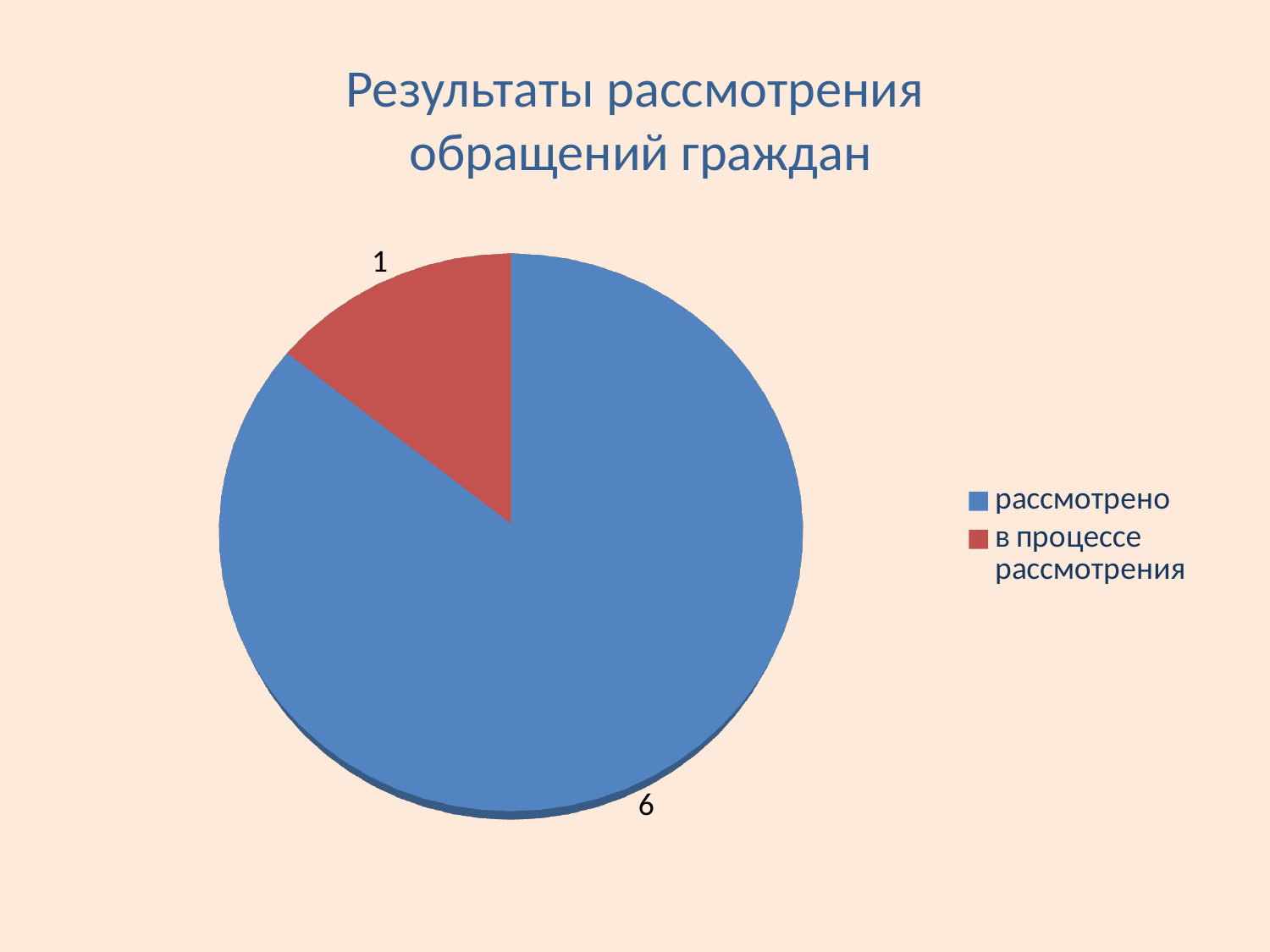
What is the total of all slices in the pie chart? 7 Which category has the smallest slice? в процессе рассмотрения What type of chart is shown on the slide? pie chart What is the value for "рассмотрено"? 6 What is the value for "в процессе рассмотрения"? 1 Which category has the largest slice? рассмотрено Which is larger: "рассмотрено" or "в процессе рассмотрения"? рассмотрено How many entries does the legend list? 2 What is the difference between the values for "рассмотрено" and "в процессе рассмотрения"? 5 What colour is the slice for "в процессе рассмотрения"? red How many slices does the pie chart have? 2 What is the title of the chart? Результаты рассмотрения обращений граждан